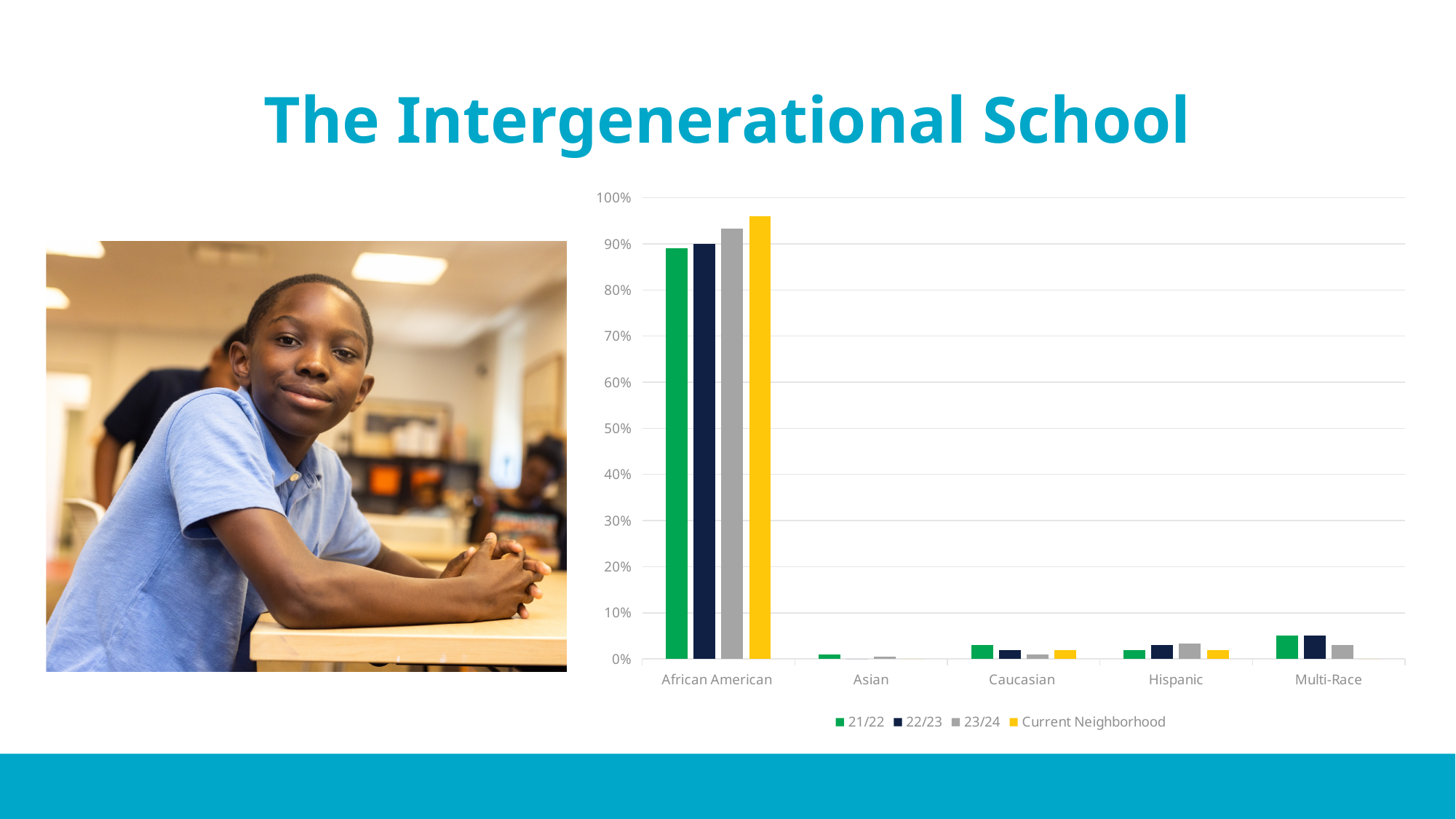
Is the Current Neighborhood value for African American greater or less than 90%? greater Is the 21/22 value for African American greater or less than 80%? greater What kind of chart is shown on the slide? bar chart Which is larger for African American: the 21/22 value or the Current Neighborhood value? Current Neighborhood Which category has the highest values in the chart? African American What colour represents the Current Neighborhood series in the chart? yellow Which is larger: the 21/22 value for African American or the 21/22 value for Caucasian? African American How many series does the chart's legend list? 4 What is the title of the slide containing the chart? The Intergenerational School Is the 21/22 value for Multi-Race greater or less than 10%? less How many categories are shown on the x axis of the chart? 5 Which category has the lowest values in the chart? Asian